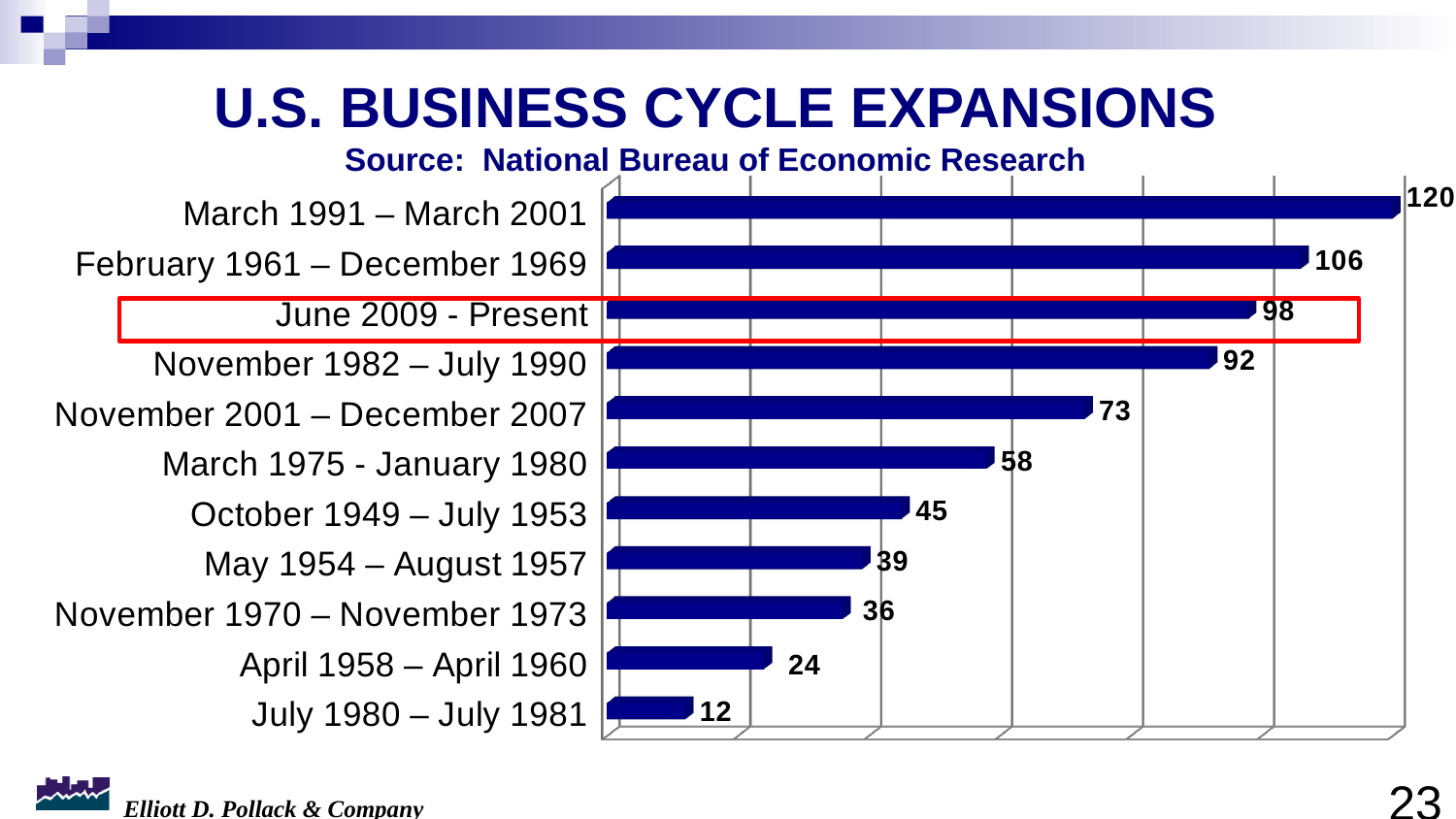
What is the difference between the values for March 1975 - January 1980 and April 1958 – April 1960? 34 What is the title of the chart? U.S. BUSINESS CYCLE EXPANSIONS What is the value for the November 2001 – December 2007 expansion? 73 Which is larger, the value for October 1949 – July 1953 or the value for May 1954 – August 1957? October 1949 – July 1953 What is the value for the March 1991 – March 2001 expansion? 120 Which expansion has the lowest value? July 1980 – July 1981 Which expansion is highlighted with a red box? June 2009 - Present What kind of chart is shown on the slide? Bar chart How many expansions are shown in the chart? 11 What is the difference between the values for February 1961 – December 1969 and November 1982 – July 1990? 14 Which expansion has the highest value? March 1991 – March 2001 What is the value for the June 2009 - Present expansion? 98